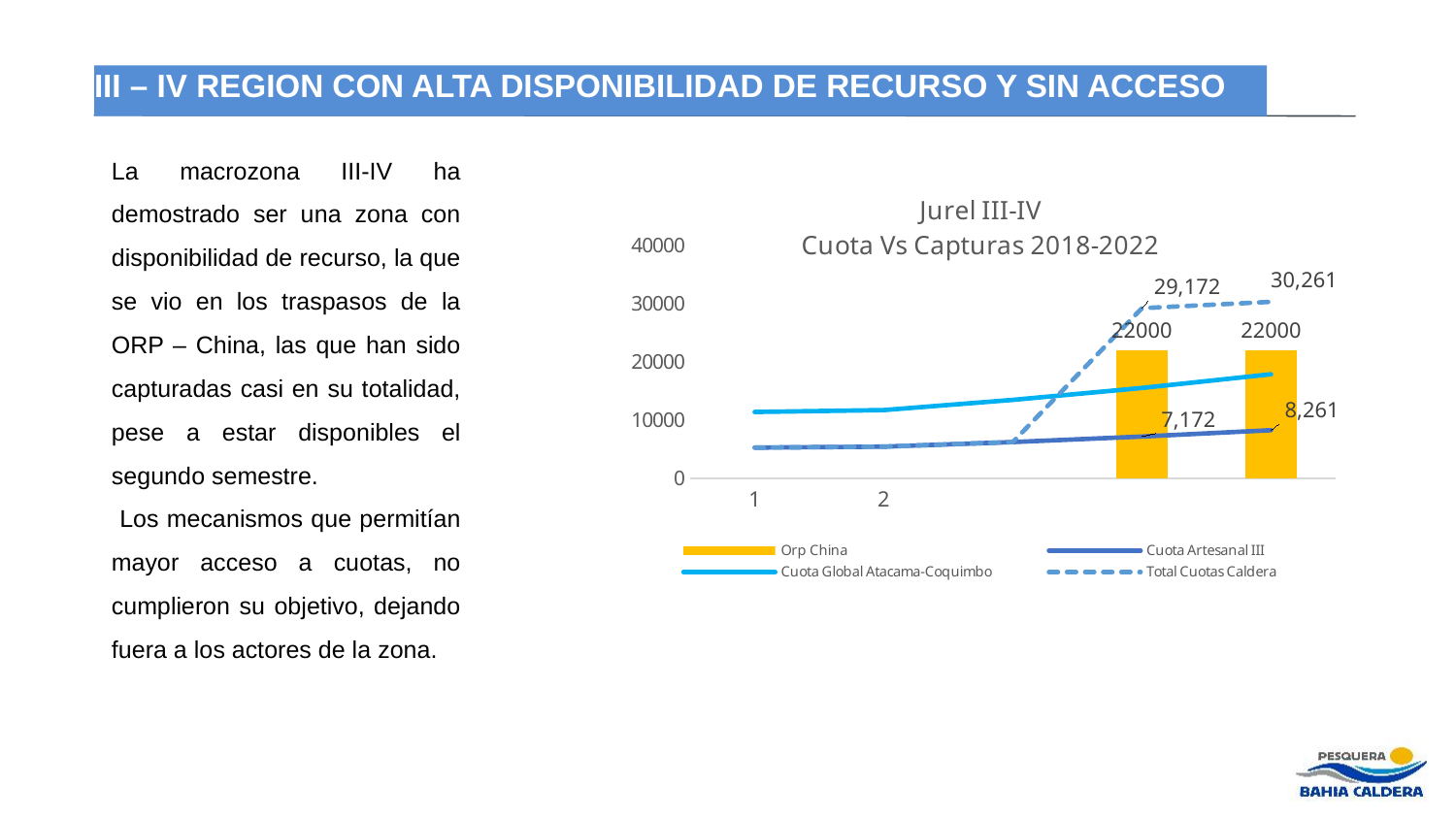
What is the title of the chart? Jurel III-IV Cuota Vs Capturas 2018-2022 What is the highest labelled value for Total Cuotas Caldera? 30,261 Does the Total Cuotas Caldera series rise or fall along the x axis? rise What is the difference between the two labelled Total Cuotas Caldera values, 30,261 and 29,172? 1,089 Which series in the chart is drawn as bars? Orp China Is the value of Cuota Artesanal III at x = 1 greater or less than 10000? less What is the difference between the last Total Cuotas Caldera label (30,261) and the Orp China bar (22000)? 8,261 Which is larger: the last labelled Total Cuotas Caldera value or the Orp China bar value? Total Cuotas Caldera How many series does the legend of the chart list? 4 What value is labelled on each of the Orp China bars? 22000 Is the value of Cuota Global Atacama-Coquimbo at x = 1 greater or less than 20000? less What is the last labelled value for Cuota Artesanal III? 8,261